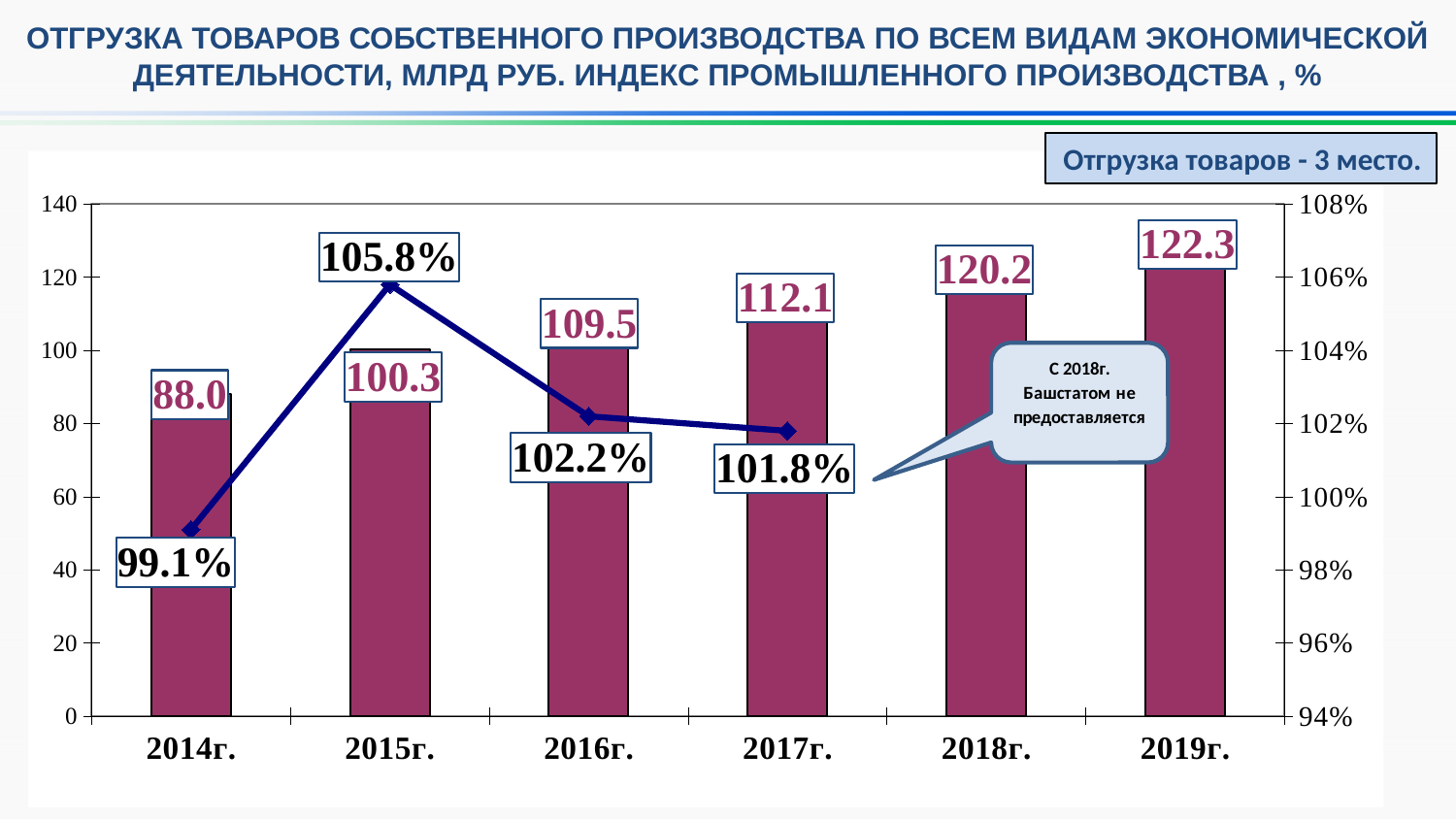
What is the shipment value (bar) for 2014г.? 88.0 What is the difference between the shipment values for 2019г. and 2014г.? 34.3 How many years are shown on the x axis? 6 What is the industrial production index (line) for 2017г.? 101.8% For how many years is the industrial production index (line) plotted? 4 Which year has the lowest industrial production index (line)? 2014г. Do the shipment values (bars) rise or fall from 2014г. to 2019г.? rise Which is larger, the shipment value for 2016г. or for 2017г.? 2017г. What is the shipment value (bar) for 2019г.? 122.3 What is the industrial production index (line) for 2015г.? 105.8% Which year has the highest shipment value (bar)? 2019г. According to the callout, from which year does Bashstat no longer provide the index data? 2018г.